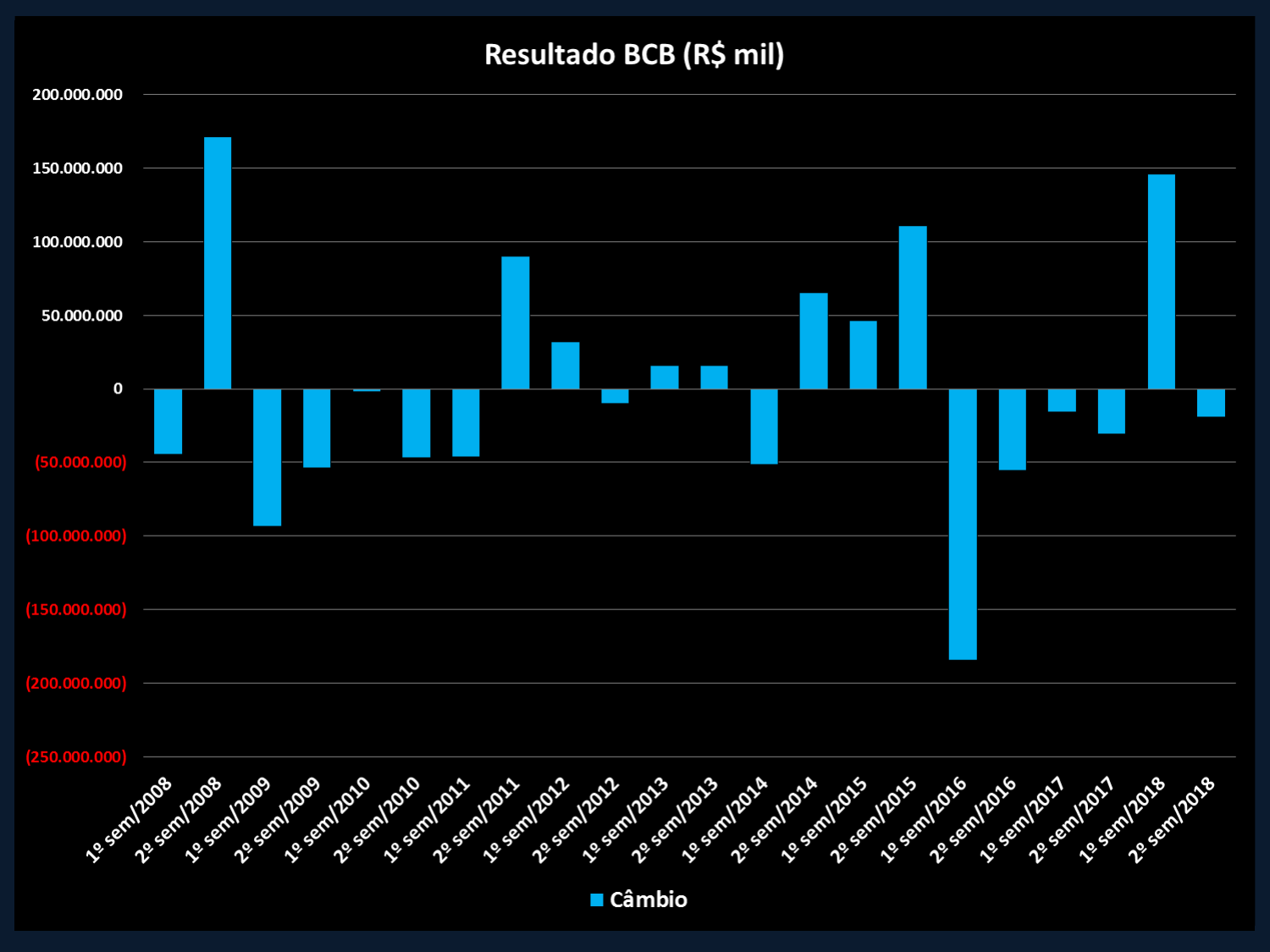
Which semester has the highest value? 2º sem/2008 What is the name of the series shown in the legend? Câmbio How many series does the legend list? 1 What type of chart is shown on the slide? Bar chart Which is larger, the value for 2º sem/2015 or the value for 2º sem/2014? 2º sem/2015 What is the title of the chart? Resultado BCB (R$ mil) Which semester has the lowest value? 1º sem/2016 Is the value for 2º sem/2008 greater or less than 150.000.000? greater Which is larger, the value for 2º sem/2008 or the value for 1º sem/2018? 2º sem/2008 Is the value for 2º sem/2015 greater or less than 100.000.000? greater Is the value for 1º sem/2016 greater or less than (150.000.000)? less How many semesters (categories) are plotted on the x axis? 22